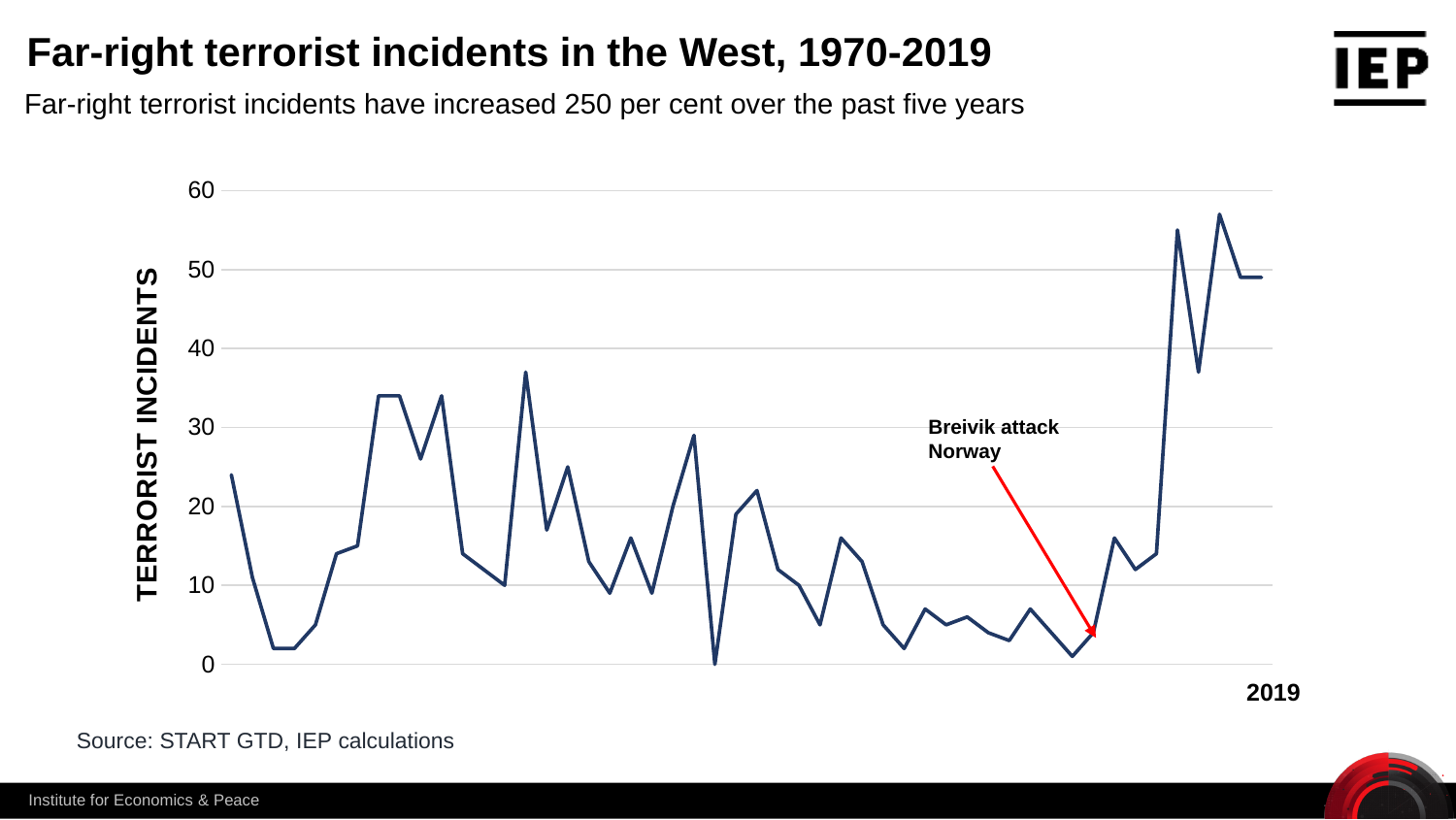
What is the title of the chart? Far-right terrorist incidents in the West, 1970-2019 What kind of chart is shown on the slide? line chart What is the label on the vertical axis of the chart? TERRORIST INCIDENTS Is the value for 2019 greater or less than 40? greater Is the value at the point annotated 'Breivik attack Norway' greater or less than 10? less Is the highest value on the chart greater or less than 50? greater After the point annotated 'Breivik attack Norway', do the values generally rise or fall toward 2019? rise